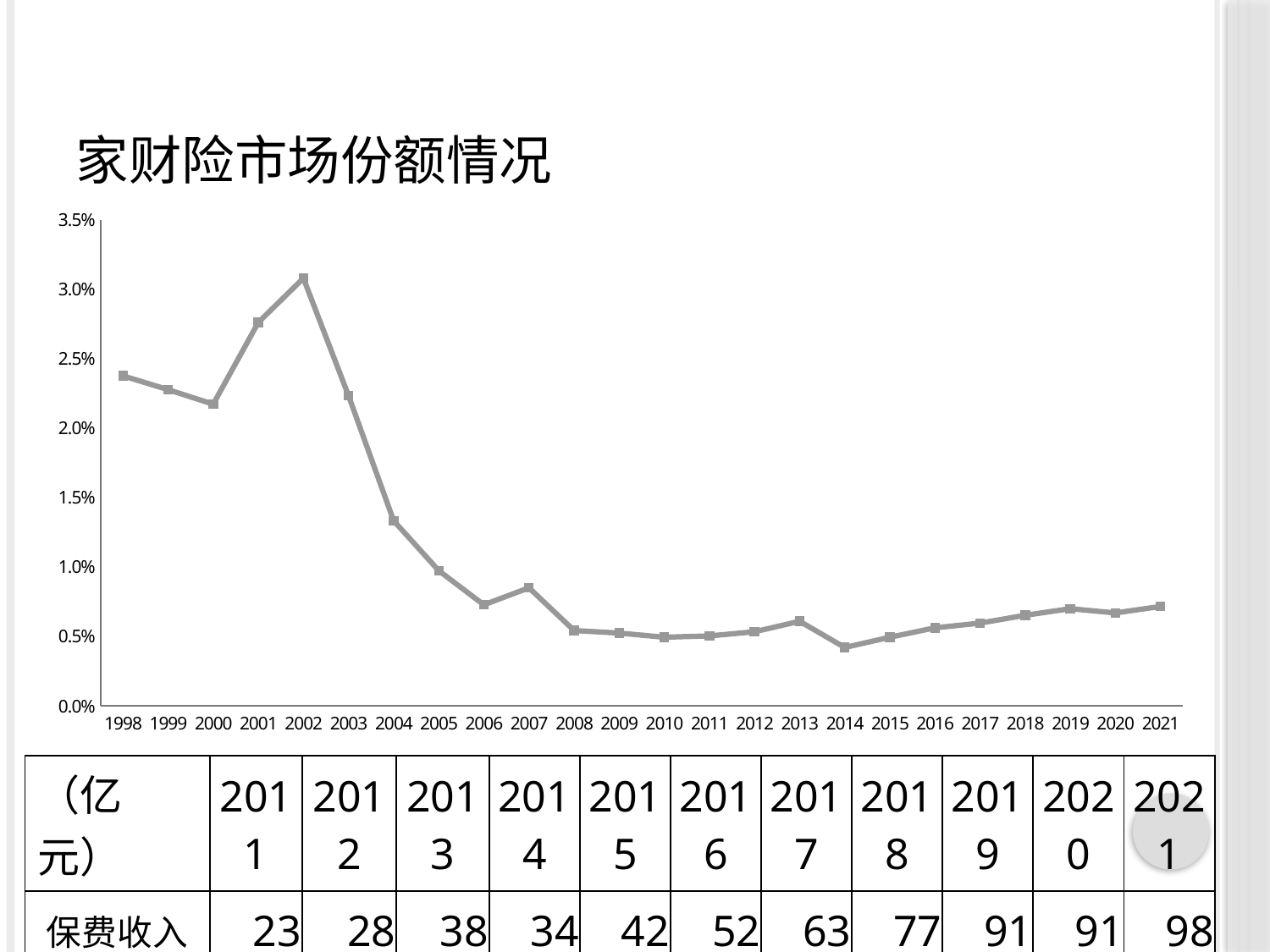
Which year has the lowest market share in the chart? 2014 Is the value for 1998 greater or less than 2.5%? less Do the values rise or fall from 2002 to 2008? fall Is the value for 2014 greater or less than 0.5%? less What kind of chart is shown on the slide? line chart How many years are plotted on the x axis of the chart? 24 What is the title of the chart? 家财险市场份额情况 Is the value for 2001 greater or less than 2.5%? greater Which year has the highest market share in the chart? 2002 Which is larger, the value for 2002 or the value for 2004? 2002